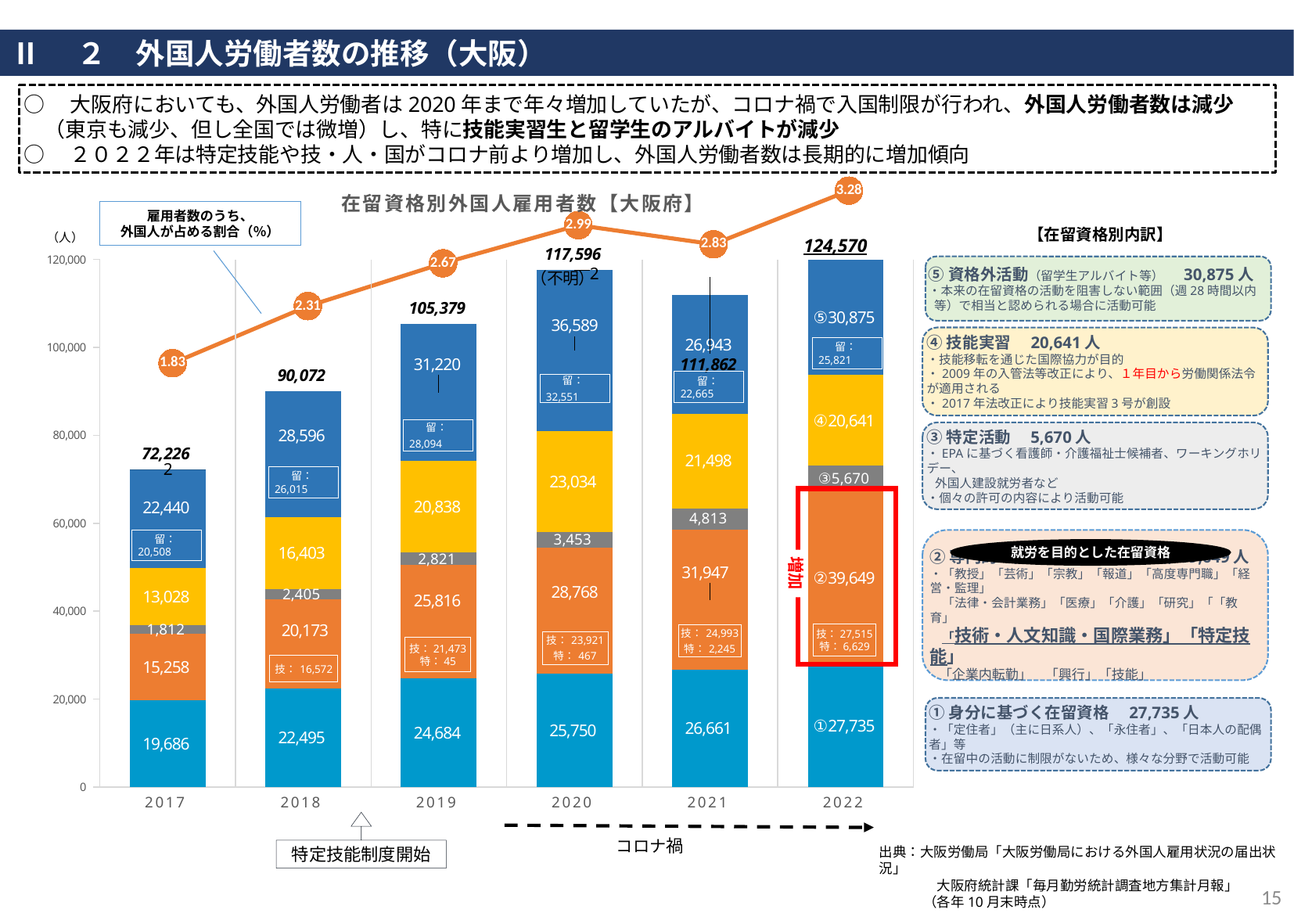
What is the value of the bottom (light blue) segment of the 2020 bar? 25,750 What value does the orange line (share of foreign workers among employees, %) show for 2022? 3.28 Which year has the highest total number of foreign workers? 2022 Which year has the lowest total number of foreign workers? 2017 What type of chart is used to show the number of foreign workers by residence status? Stacked bar chart with a line overlay What value does the orange line show for 2017? 1.83 How many years (bars) are shown on the x axis of the chart? 6 What is the value of the orange segment (②) in the 2022 bar? 39,649 Which is larger: the yellow segment in 2020 (23,034) or the yellow segment in 2021 (21,498)? 2020 (23,034) What is the total number of foreign workers in Osaka shown for 2022? 124,570 What is the total number of foreign workers shown for 2017? 72,226 What is the difference between the total for 2020 (117,596) and the total for 2021 (111,862)? 5,734